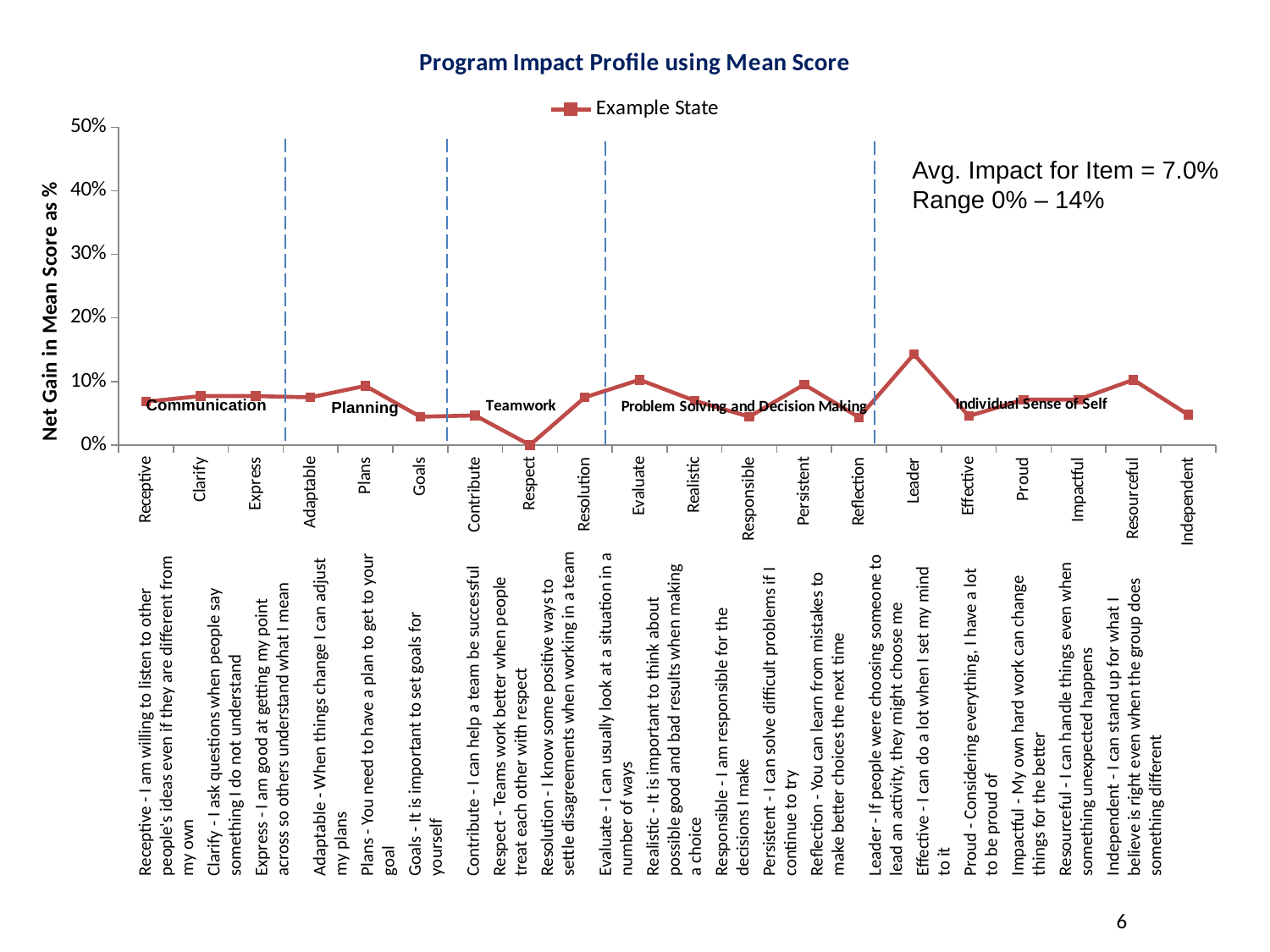
What is the title of the chart? Program Impact Profile using Mean Score What is the name of the series shown in the legend? Example State What is the net gain in mean score for Respect? 0% What kind of chart is shown on the slide? line chart How many series does the legend list? 1 Which item has the lowest net gain in mean score? Respect Which has a larger value, Evaluate or Responsible? Evaluate Which has a larger value, Persistent or Reflection? Persistent Is the value for Goals greater or less than 10%? less How many items (categories) are plotted along the x axis? 20 Is the value for Leader greater or less than 10%? greater Which item has the highest net gain in mean score? Leader